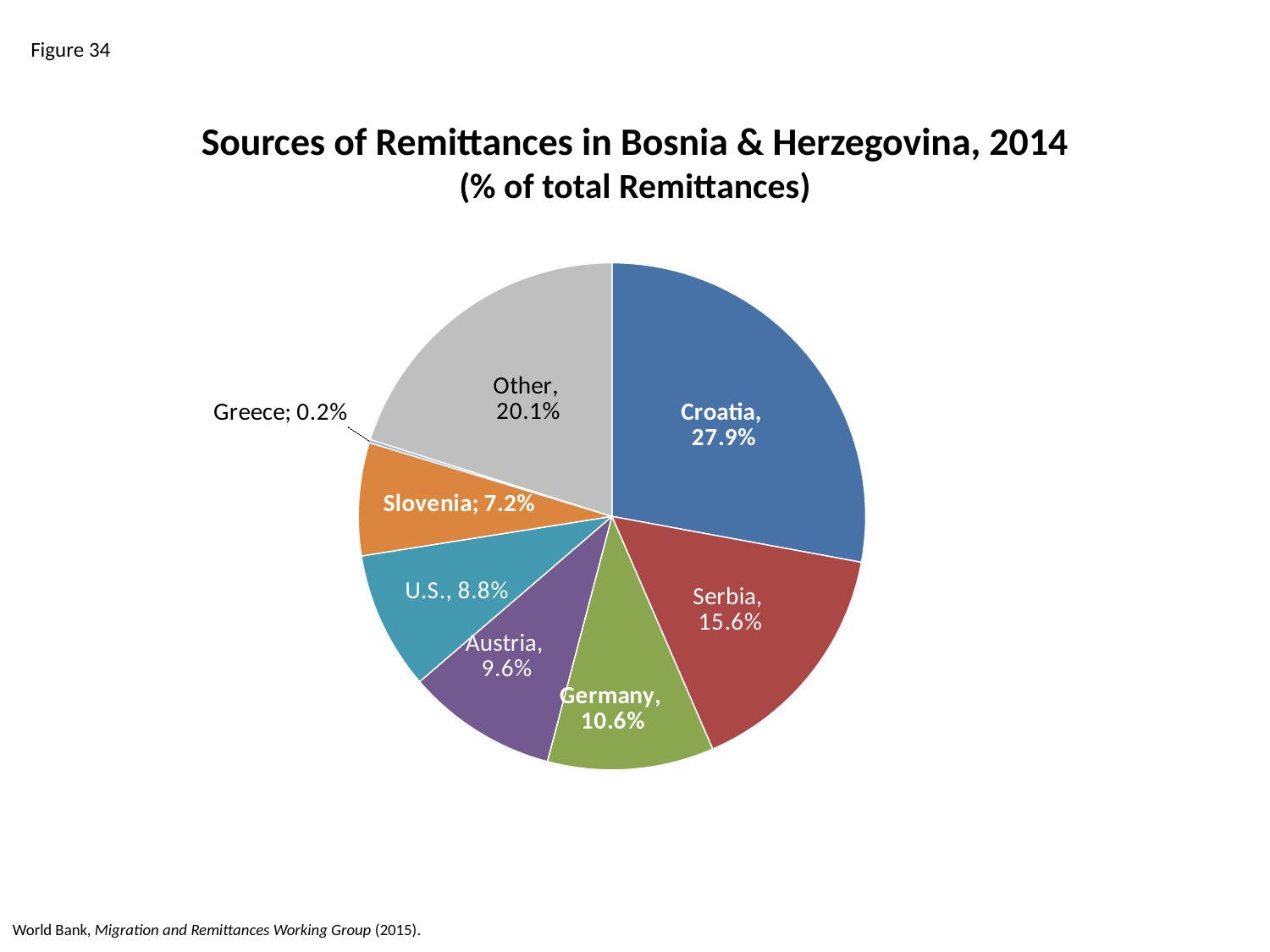
What share of remittances comes from Greece? 0.2% Which source has the largest share of remittances? Croatia Which has a larger share of remittances, Austria or the U.S.? Austria What is the title of the chart? Sources of Remittances in Bosnia & Herzegovina, 2014 (% of total Remittances) What kind of chart is shown on the slide? Pie chart How many slices does the pie chart have? 8 What share of remittances comes from Croatia? 27.9% What share of remittances comes from Serbia? 15.6% Which source has the smallest share of remittances? Greece What colour is the slice for Slovenia? Orange What is the difference in percentage points between Croatia's share and Serbia's share? 12.3 What share of remittances comes from Germany? 10.6%